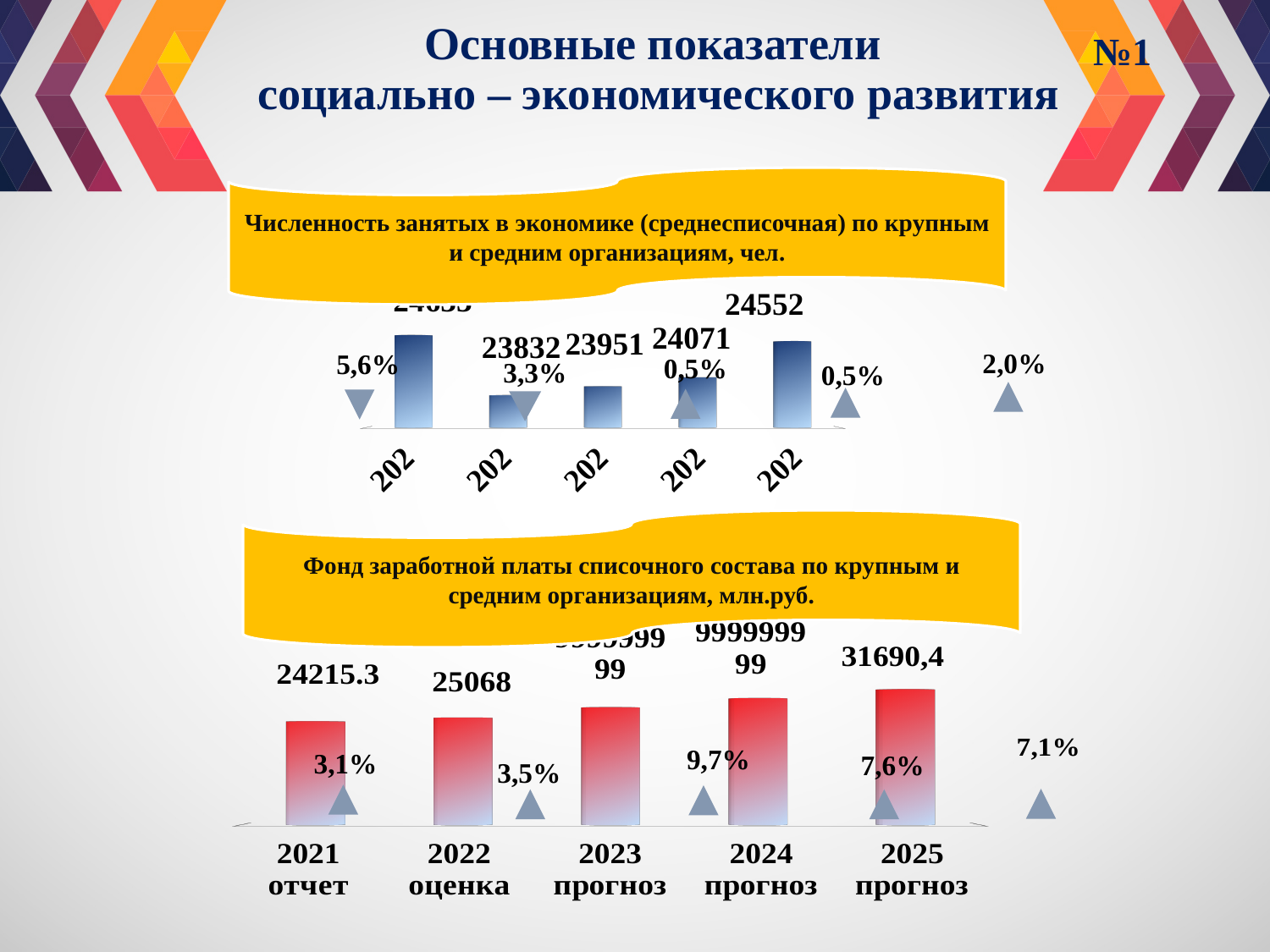
In the top chart (Численность занятых в экономике), what is the value shown on the fifth bar from the left? 24552 In the bottom chart (Фонд заработной платы), which year has the highest value? 2025 прогноз In the bottom chart (Фонд заработной платы), what is the value for 2025 прогноз? 31690,4 What is the title of the bottom chart? Фонд заработной платы списочного состава по крупным и средним организациям, млн.руб. In the bottom chart (Фонд заработной платы), what is the value for 2021 отчет? 24215.3 In the bottom chart (Фонд заработной платы), what is the value for 2022 оценка? 25068 In the bottom chart (Фонд заработной платы), which is larger: the value for 2022 оценка or 2025 прогноз? 2025 прогноз In the bottom chart (Фонд заработной платы), which year has the lowest value? 2021 отчет In the bottom chart (Фонд заработной платы), how many bars are plotted? 5 In the top chart (Численность занятых в экономике), what is the value shown on the second bar from the left? 23832 In the bottom chart (Фонд заработной платы), do the values rise or fall from 2021 to 2025? rise What kind of chart is the top chart (Численность занятых в экономике)? bar chart